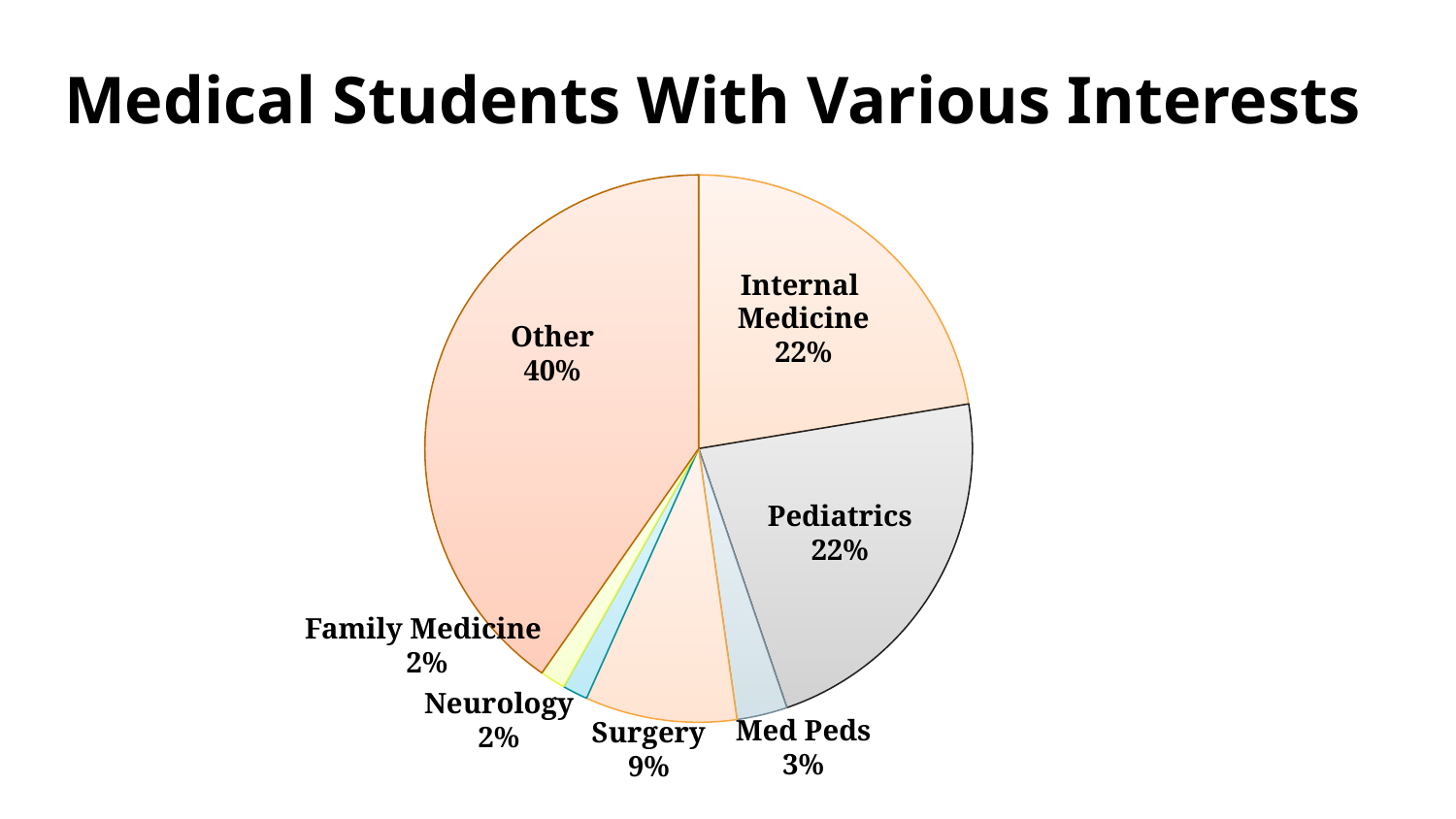
What is the difference between the Surgery share and the Neurology share? 7% How many slices does the pie chart have? 7 Which category has the largest slice of the pie? Other What is the difference between the Other share and the Pediatrics share? 18% Which is larger, Surgery or Med Peds? Surgery What kind of chart is shown on the slide? pie chart What is the title of the chart? Medical Students With Various Interests What percentage is shown for Surgery? 9% What is the combined share of Internal Medicine and Pediatrics? 44% What share of the pie is Other? 40% What percentage is shown for Med Peds? 3% What percentage is shown for Internal Medicine? 22%